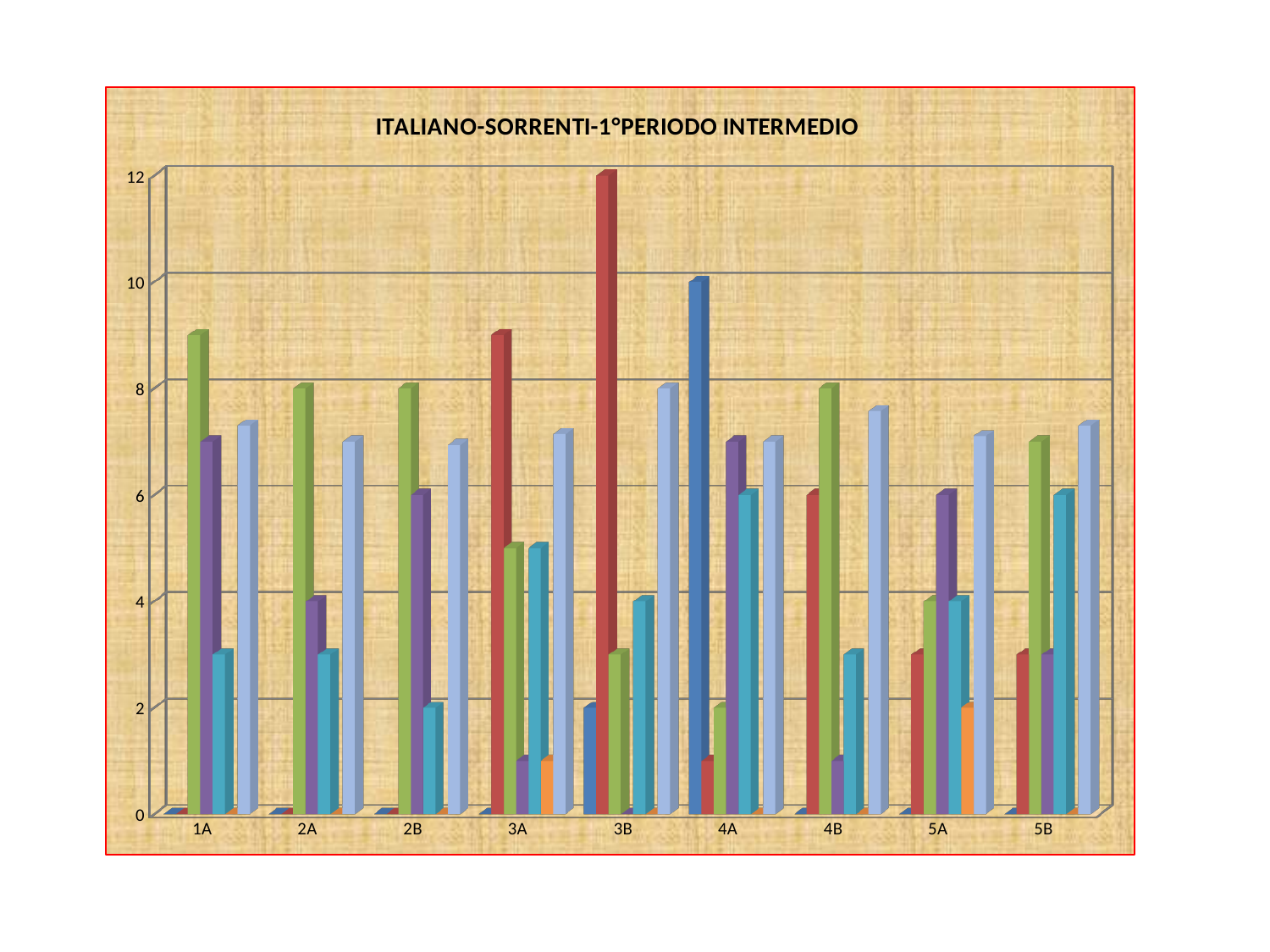
Which is larger, the green bar for 3A or the green bar for 3B? 3A Is the value of the purple bar for 5A greater or less than 4? greater Which category contains the tallest bar in the chart? 3B Is the value of the red bar for 3B greater or less than 10? greater What colour is the tallest bar in the chart? red What is the title of the chart? ITALIANO-SORRENTI-1°PERIODO INTERMEDIO Is the value of the cyan bar for 2B greater or less than 4? less How many categories are shown on the x axis of the chart? 9 Which is larger, the red bar for 3A or the red bar for 3B? 3B What kind of chart is shown on the slide? bar chart